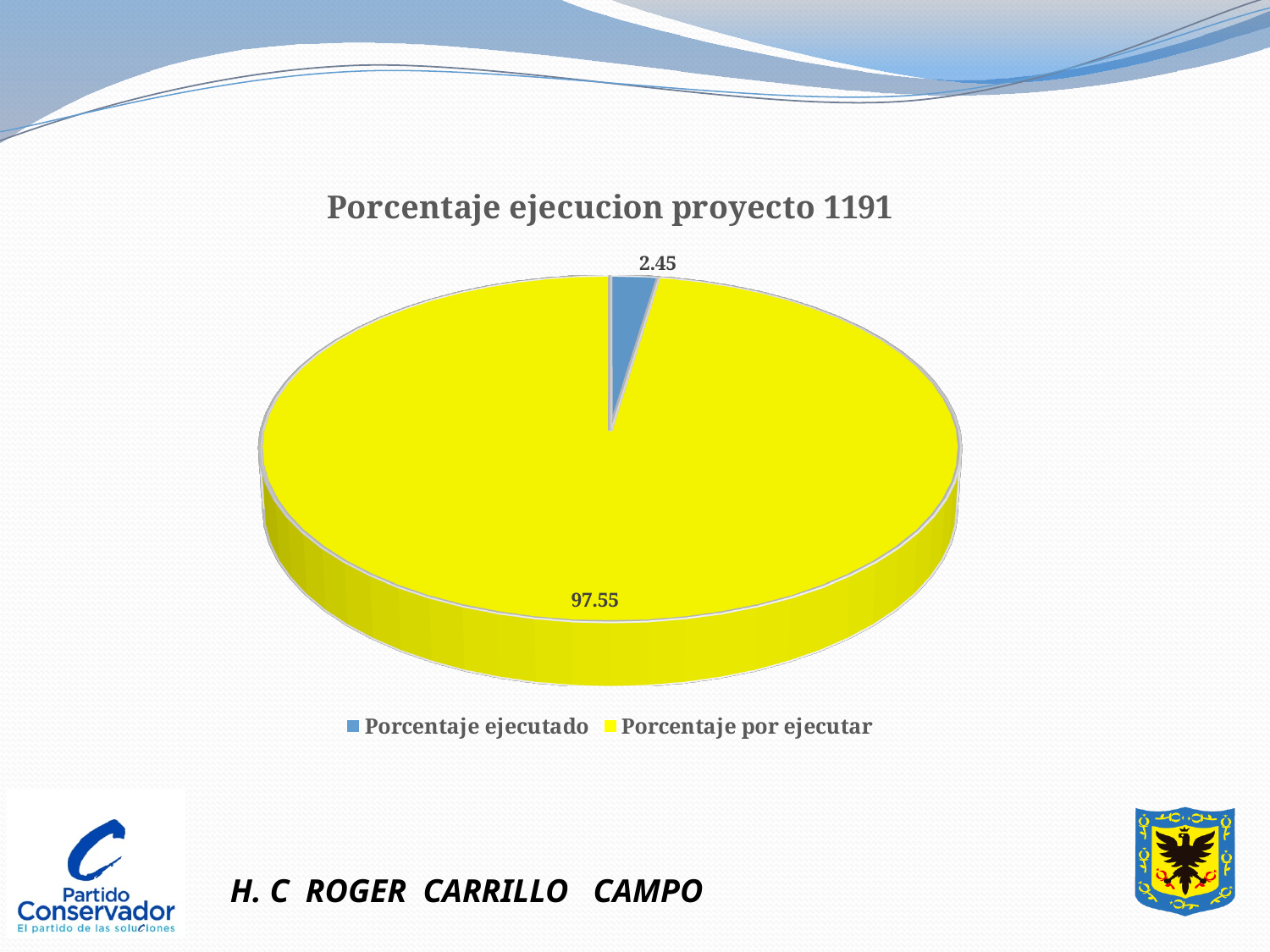
Which is larger, Porcentaje ejecutado or Porcentaje por ejecutar? Porcentaje por ejecutar Which category has the largest slice of the pie? Porcentaje por ejecutar What is the value for Porcentaje por ejecutar? 97.55 How many slices does the pie chart have? 2 What colour is the slice for Porcentaje por ejecutar? Yellow What kind of chart is shown on the slide? Pie chart What is the value for Porcentaje ejecutado? 2.45 Which category has the smallest slice of the pie? Porcentaje ejecutado What is the title of the chart? Porcentaje ejecucion proyecto 1191 What is the difference between the values for Porcentaje por ejecutar and Porcentaje ejecutado? 95.1 How many entries does the legend list? 2 What is the total of the two slice values? 100